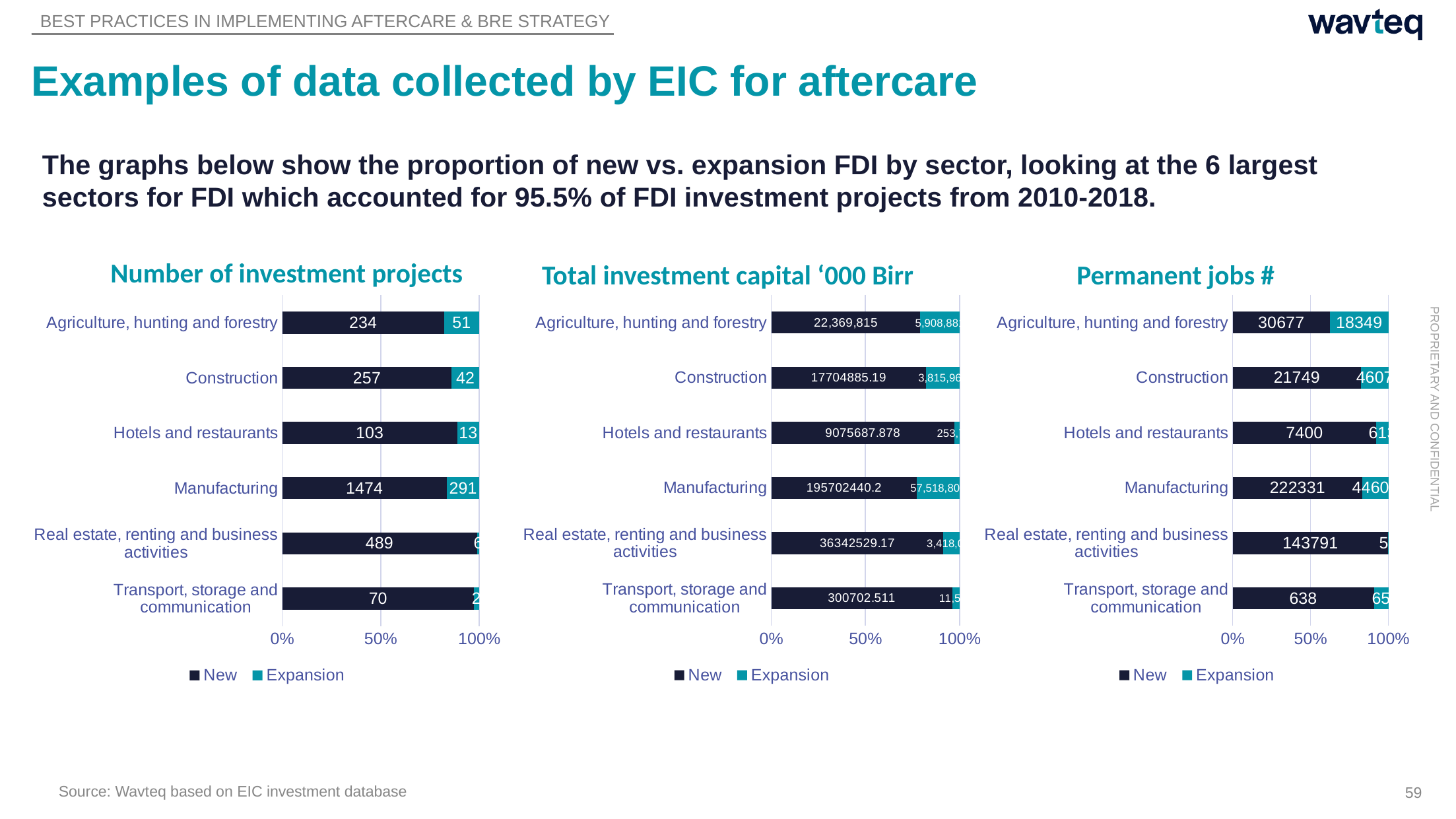
In the 'Number of investment projects' chart, what is the difference between the New values for Construction and Agriculture, hunting and forestry? 23 In the 'Permanent jobs #' chart, what is the New value for Real estate, renting and business activities? 143791 In the 'Number of investment projects' chart, what is the total of the New and Expansion values for Agriculture, hunting and forestry? 285 In the 'Permanent jobs #' chart, which is larger: the New value for Construction or the New value for Agriculture, hunting and forestry? Agriculture, hunting and forestry What type of chart is the 'Number of investment projects' chart? Stacked bar chart How many series does the legend of the 'Total investment capital ‘000 Birr' chart list? 2 In the 'Number of investment projects' chart, what is the New value for Manufacturing? 1474 In the 'Permanent jobs #' chart, which sector has the lowest New value? Transport, storage and communication How many sectors are shown in the 'Permanent jobs #' chart? 6 In the 'Number of investment projects' chart, what is the Expansion value for Agriculture, hunting and forestry? 51 In the 'Number of investment projects' chart, which sector has the highest New value? Manufacturing In the 'Total investment capital ‘000 Birr' chart, what is the New value for Hotels and restaurants? 9075687.878